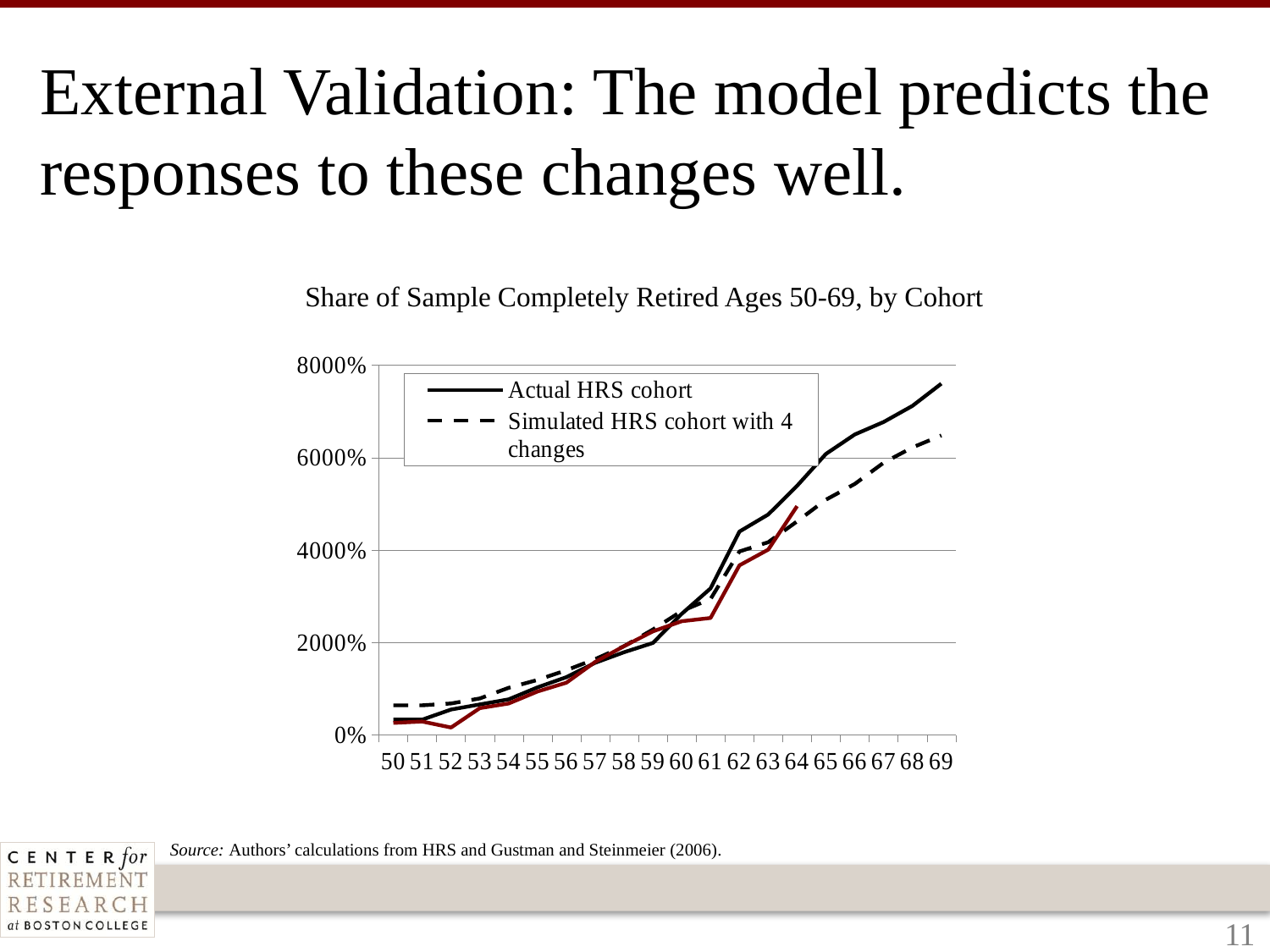
Which series is drawn with a dashed line? Simulated HRS cohort with 4 changes Is the value for the Simulated HRS cohort with 4 changes at age 50 greater or less than 2000%? less What is the title of the chart? Share of Sample Completely Retired Ages 50-69, by Cohort Do the values for the Actual HRS cohort rise or fall as age increases from 50 to 69? Rise At age 50, which series has the higher value: Actual HRS cohort or Simulated HRS cohort with 4 changes? Simulated HRS cohort with 4 changes How many age points are shown along the x axis? 20 Is the value for the Actual HRS cohort at age 61 greater or less than 2000%? greater How many series does the chart's legend list? 2 What kind of chart is shown on the slide? Line chart At age 69, which series has the higher value: Actual HRS cohort or Simulated HRS cohort with 4 changes? Actual HRS cohort Is the value for the Actual HRS cohort at age 69 greater or less than 6000%? greater